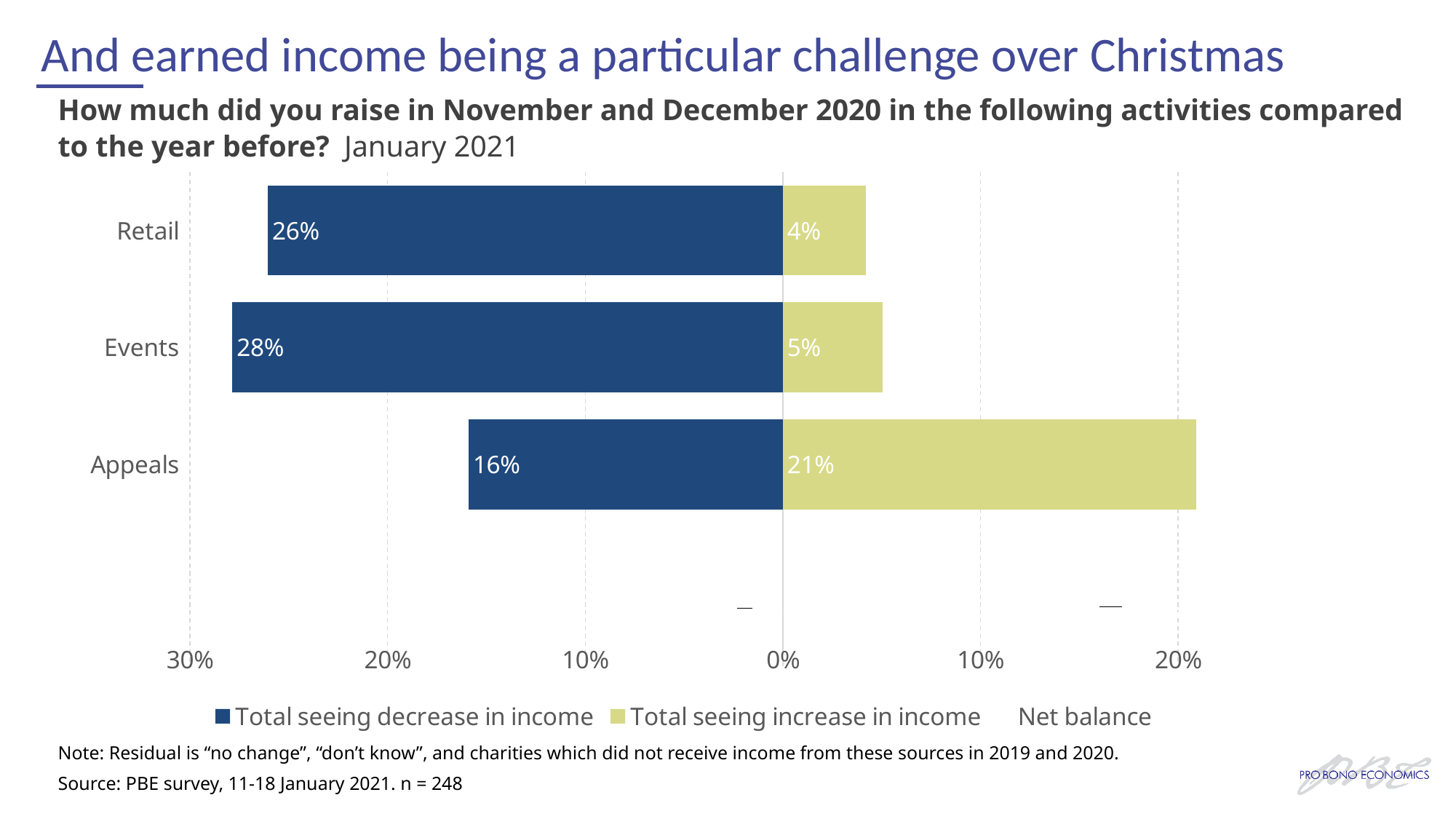
What percentage of charities saw a decrease in income from Retail? 26% Which activity has the lowest share of charities seeing an increase in income? Retail What type of chart is shown on the slide? Bar chart What is the difference between the share seeing a decrease and the share seeing an increase in income from Events? 23 percentage points Which activity has the highest share of charities seeing a decrease in income? Events What percentage of charities saw an increase in income from Appeals? 21% Which colour represents 'Total seeing increase in income'? Yellow-green What percentage of charities saw an increase in income from Retail? 4% What percentage of charities saw a decrease in income from Events? 28% For Appeals, is the share seeing an increase in income larger or smaller than the share seeing a decrease? larger How many entries does the legend list? 3 How many activities are shown on the chart? 3